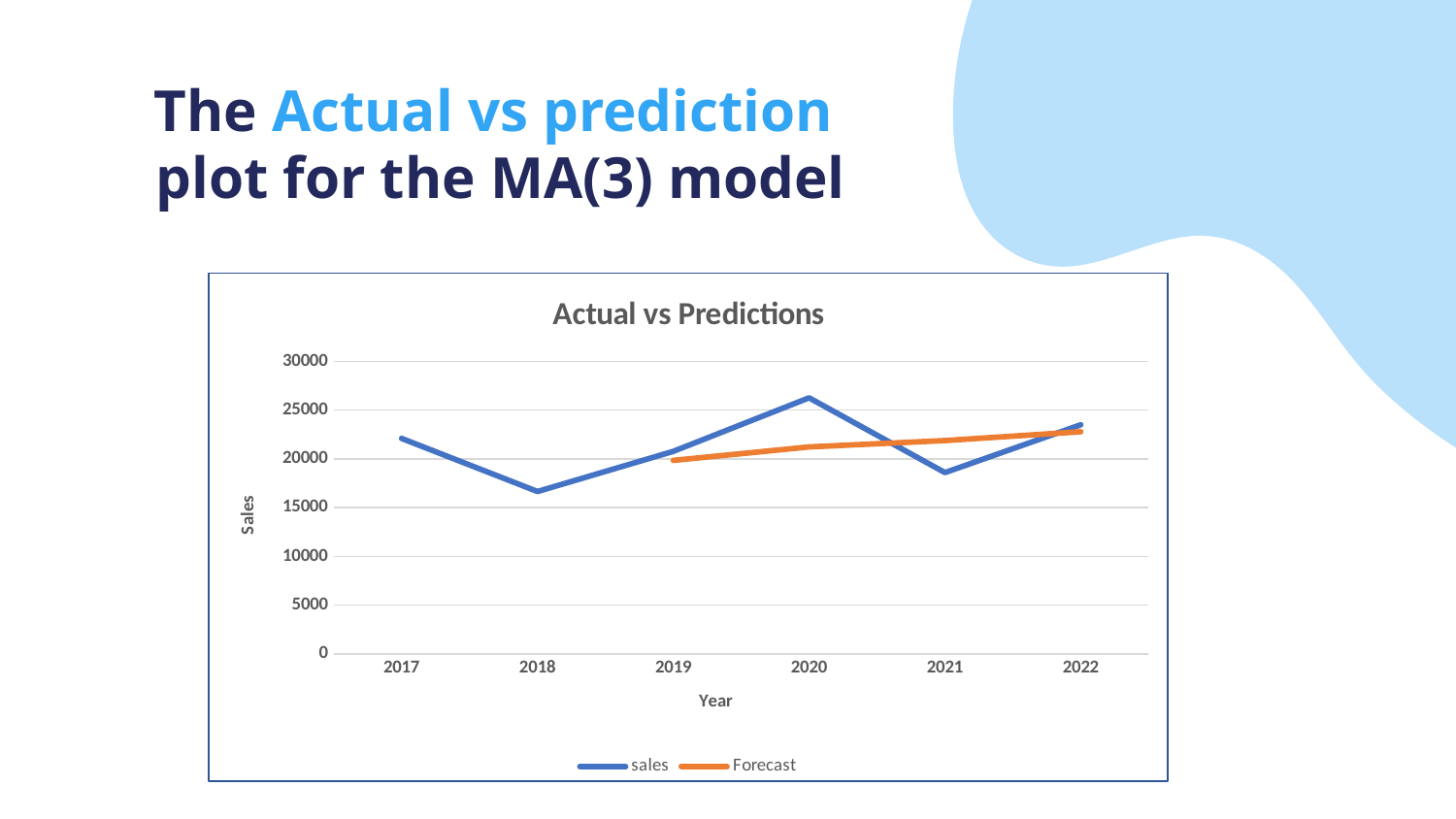
How many series does the chart's legend list? 2 Is the sales value for 2018 greater or less than 20000? less What is the title of the chart? Actual vs Predictions Does the Forecast series rise or fall from 2019 to 2022? rise What is the label on the vertical axis of the chart? Sales In 2021, which series has the higher value, sales or Forecast? Forecast In which year is the sales series at its lowest? 2018 What kind of chart is shown on the slide? line chart Is the sales value for 2020 greater or less than 25000? greater In which year is the sales series at its highest? 2020 How many years are shown on the x axis of the chart? 6 Is the sales value for 2021 greater or less than 20000? less